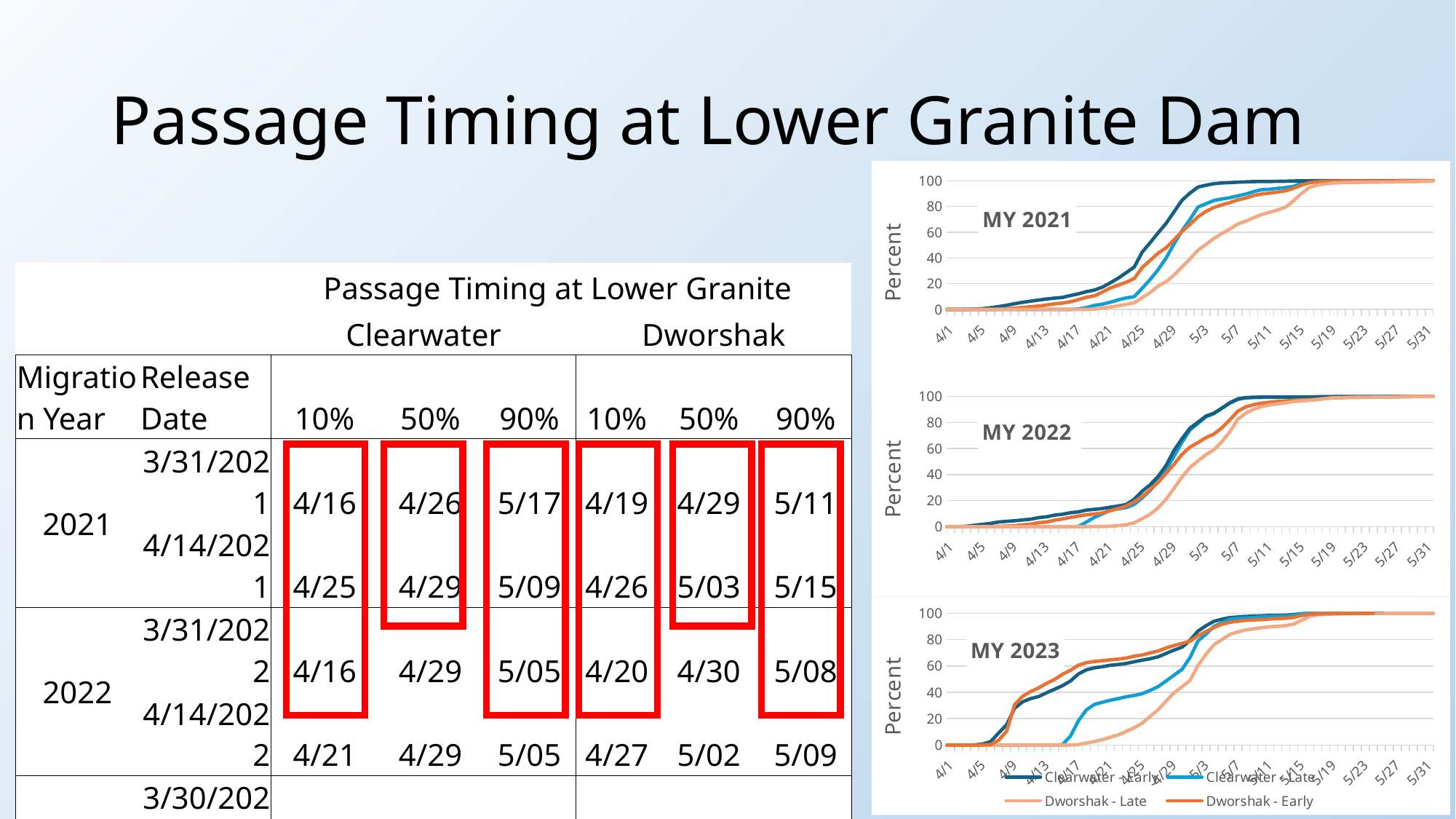
In the MY 2023 chart, which is larger at 4/29: Dworshak - Early or Dworshak - Late? Dworshak - Early In the MY 2023 chart, which is larger at 4/21: Clearwater - Early or Clearwater - Late? Clearwater - Early What is the highest value shown on the y-axis of the MY 2023 chart? 100 How many series does the legend below the MY 2023 chart list? 4 In the MY 2023 chart, is the value for Dworshak - Late at 4/25 greater or less than 20? less In the MY 2021 chart, do the lines rise or fall as the dates move from 4/1 to 5/31? rise What is the y-axis label on the MY 2022 chart? Percent In the MY 2022 chart, is the value for Clearwater - Early at 4/21 greater or less than 20? less What kind of chart is the MY 2021 chart on the right of the slide? line chart In the MY 2023 chart, which series has the lowest value at 4/25? Dworshak - Late How many charts are shown on the right side of the slide? 3 In the MY 2021 chart, is the value for Clearwater - Early at 5/3 greater or less than 80? greater